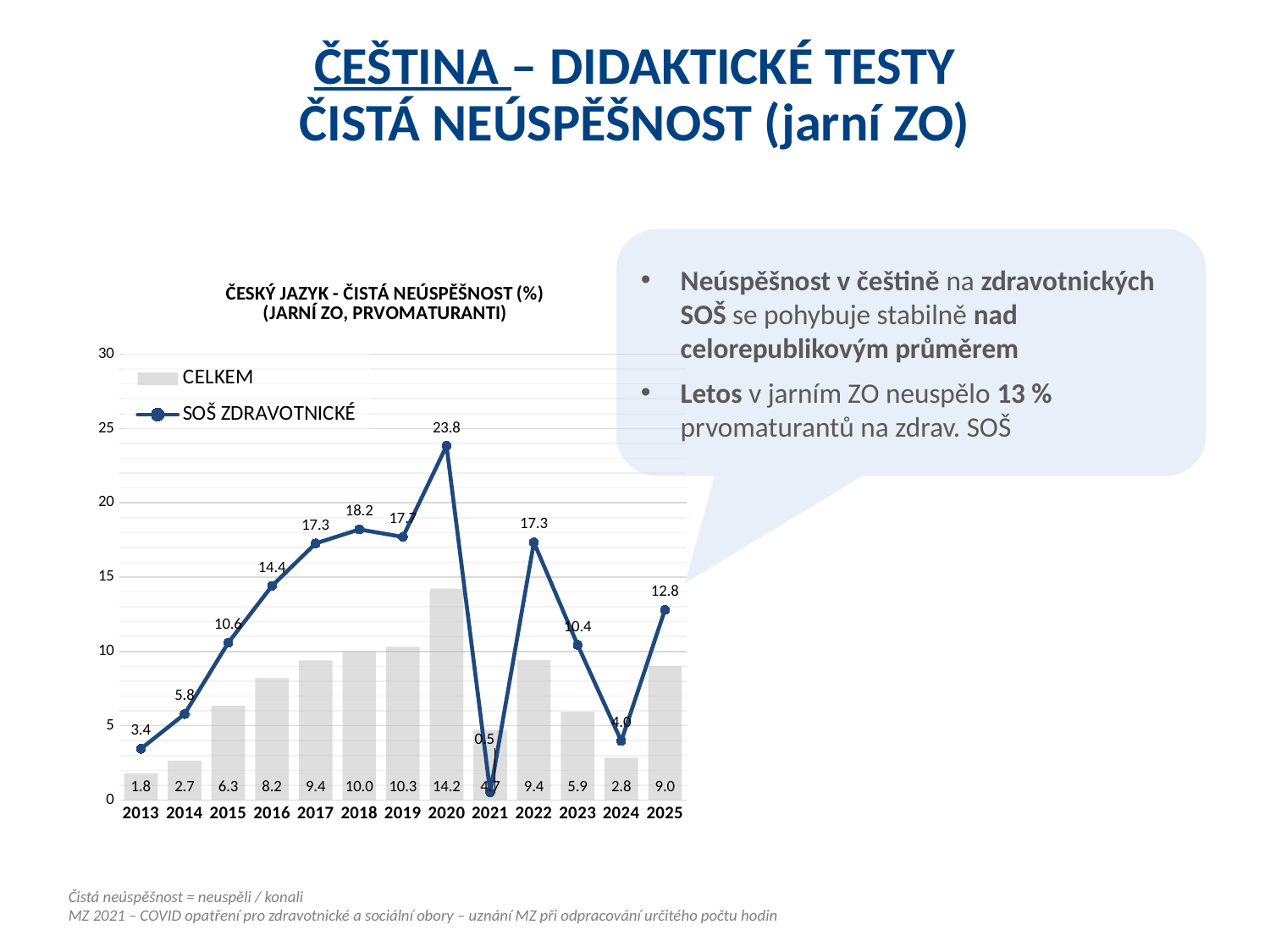
What is the value for CELKEM in 2020? 14.2 In which year is the SOŠ ZDRAVOTNICKÉ value highest? 2020 How many series does the chart legend list? 2 In 2025, which is larger: the SOŠ ZDRAVOTNICKÉ value or the CELKEM value? SOŠ ZDRAVOTNICKÉ How many years are shown on the x axis of the chart? 13 In which year is the CELKEM value lowest? 2013 What is the value for SOŠ ZDRAVOTNICKÉ in 2020? 23.8 What kind of chart is shown on the slide? Combination bar and line chart In which year is the SOŠ ZDRAVOTNICKÉ value lowest? 2021 Does the SOŠ ZDRAVOTNICKÉ value rise or fall from 2013 to 2018? Rise What is the difference between the SOŠ ZDRAVOTNICKÉ and CELKEM values in 2020? 9.6 What is the value for CELKEM in 2018? 10.0